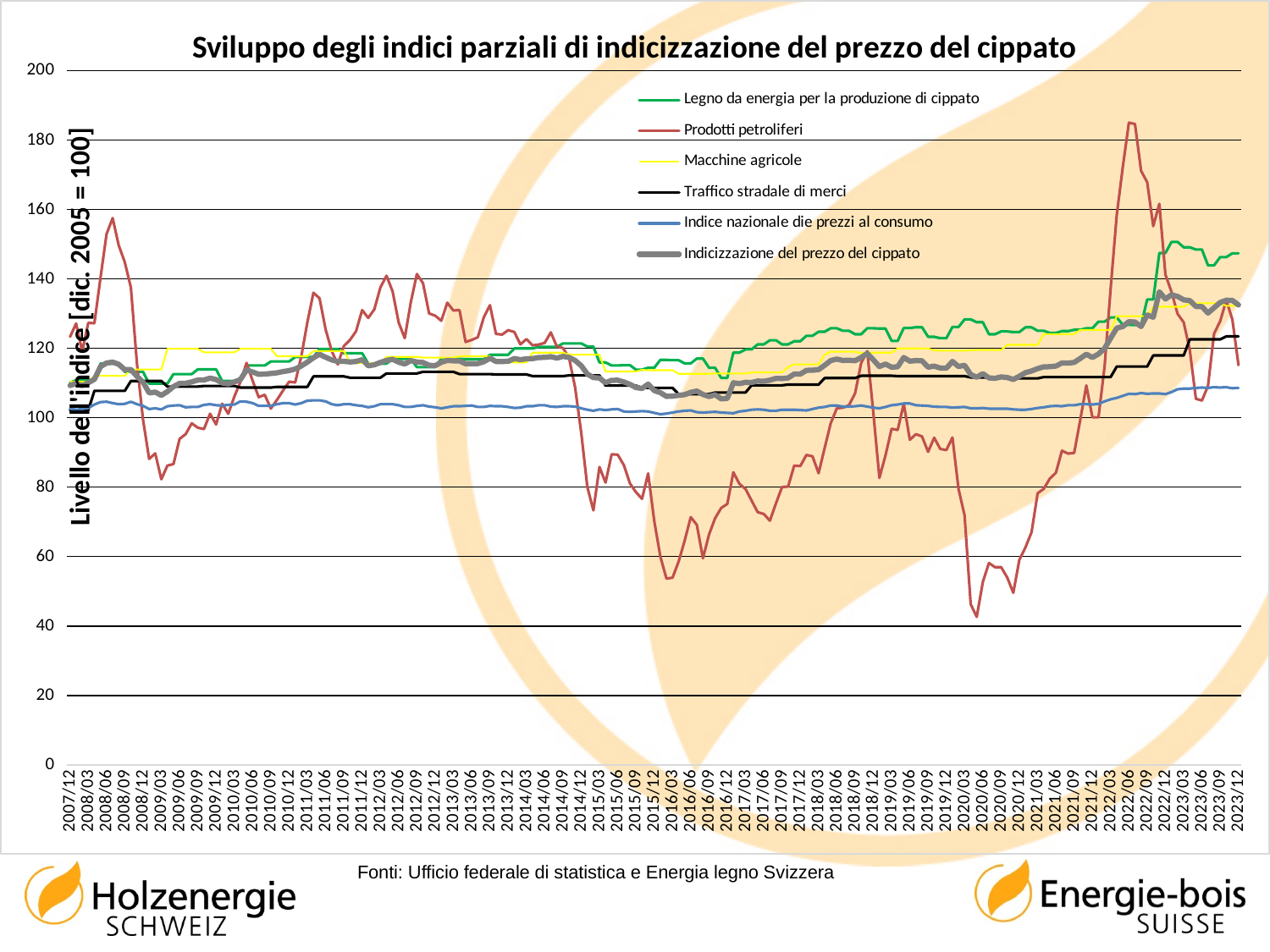
Which series is drawn with the thick grey line? Indicizzazione del prezzo del cippato Does the Traffico stradale di merci series rise or fall from 2007/12 to 2023/12? rise At 2023/12, which is higher: Legno da energia per la produzione di cippato or Indice nazionale dei prezzi al consumo? Legno da energia per la produzione di cippato Which series reaches the highest value anywhere on the chart? Prodotti petroliferi Is the lowest value of Prodotti petroliferi in 2020 greater or less than 60? less Is the peak value of Prodotti petroliferi in 2022 greater or less than 160? greater What kind of chart is shown on the slide? line chart How many series does the legend list? 6 Is the value for Indice nazionale dei prezzi al consumo at 2023/12 greater or less than 120? less Which series falls to the lowest value anywhere on the chart? Prodotti petroliferi What is the title of the chart? Sviluppo degli indici parziali di indicizzazione del prezzo del cippato